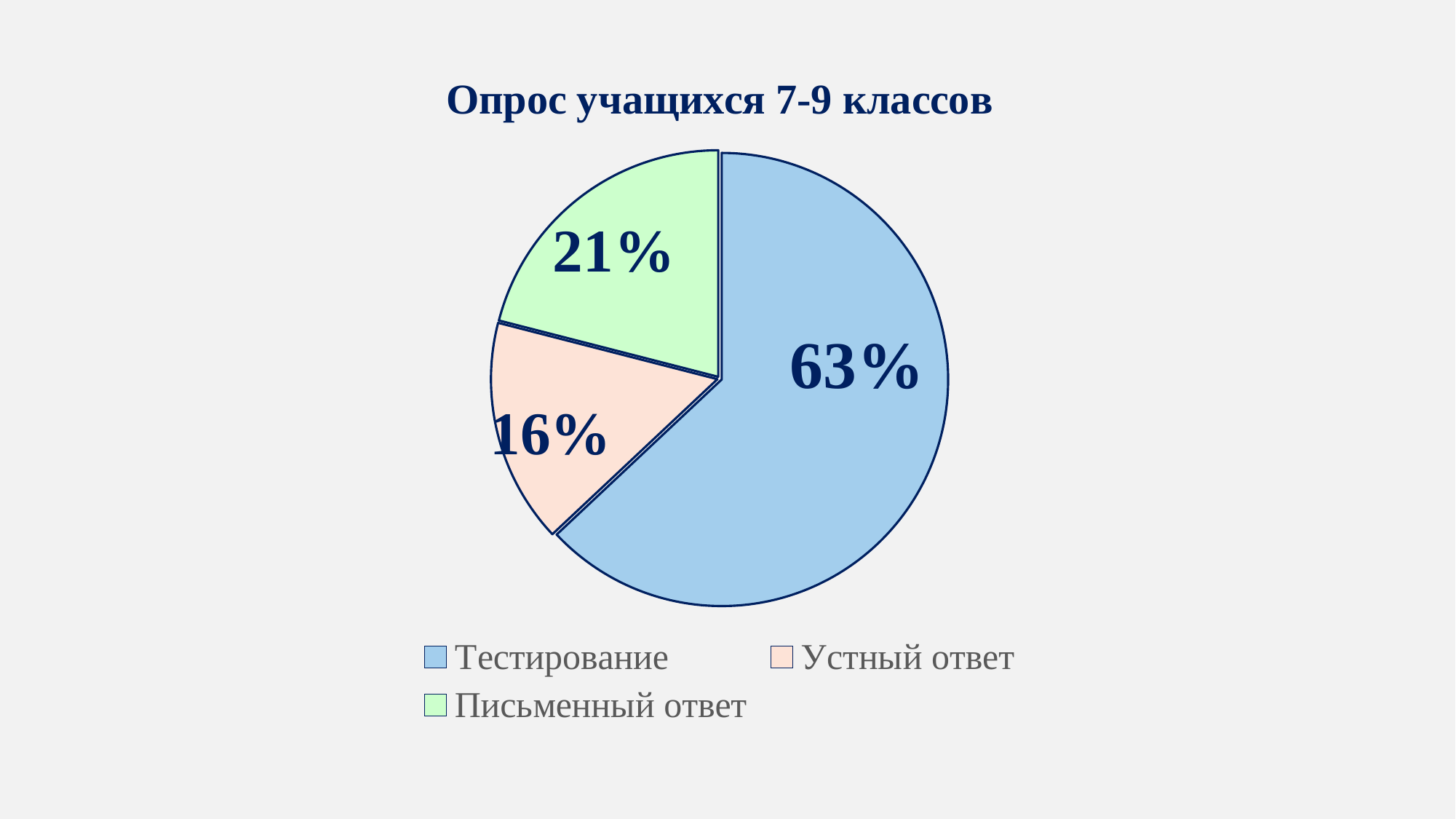
What kind of chart is shown on the slide? Pie chart Which is larger, the share for Устный ответ or the share for Письменный ответ? Письменный ответ Which category has the largest slice of the pie? Тестирование Which category is shown in green in the legend? Письменный ответ What is the difference in percentage points between Тестирование and Письменный ответ? 42 What is the title of the chart? Опрос учащихся 7-9 классов What is the difference in percentage points between Письменный ответ and Устный ответ? 5 Which category has the smallest slice of the pie? Устный ответ What share of the pie does Устный ответ have? 16% What share of the pie does Письменный ответ have? 21% How many categories does the pie chart show? 3 What share of the pie does Тестирование have? 63%